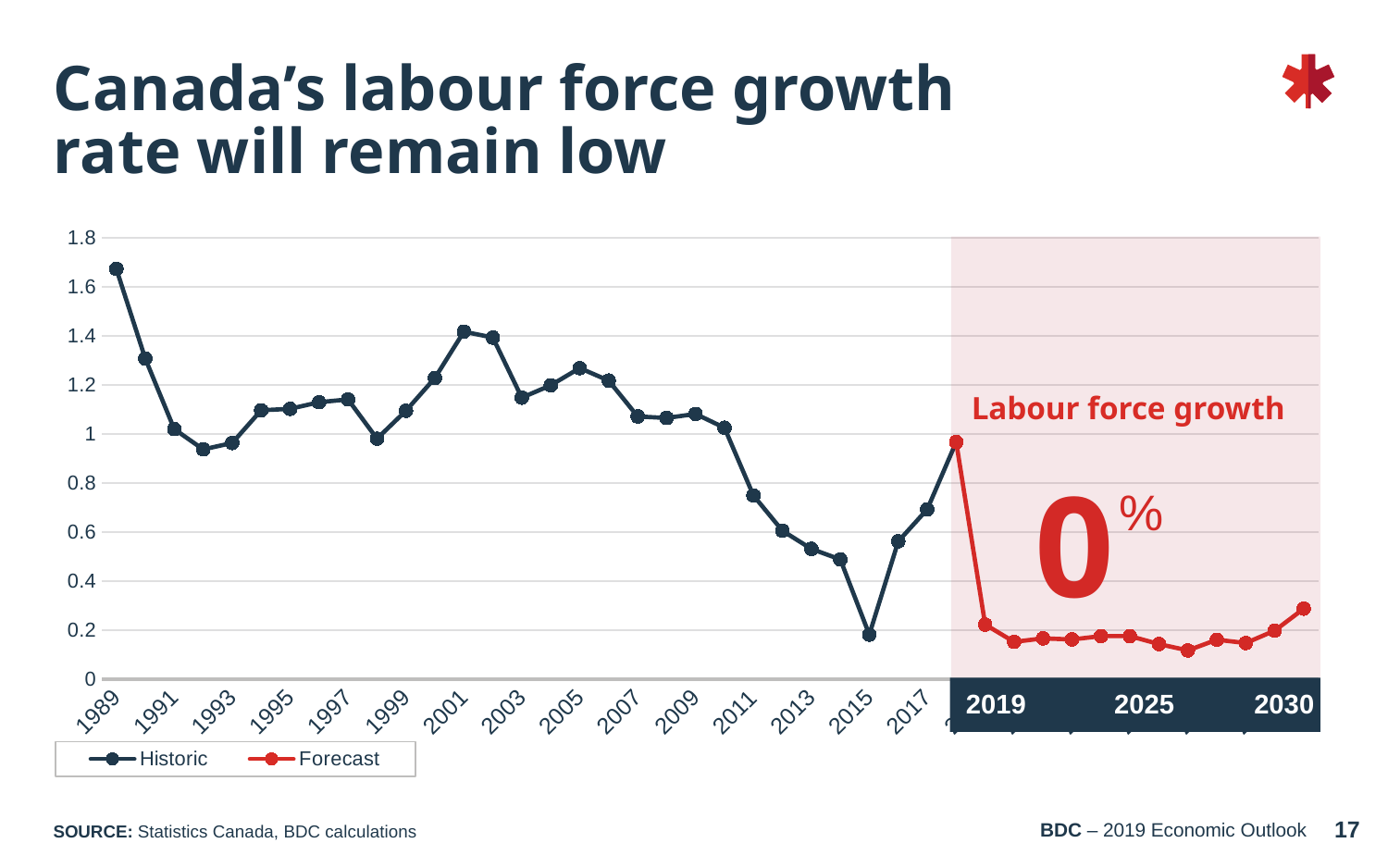
What are the two series named in the legend? Historic and Forecast Is the value for 1989 greater or less than 1.6? greater In which year is the labour force growth rate highest? 1989 What kind of chart is shown on the slide? Line chart Is the value for 2017 greater or less than 0.8? less How many series does the legend list? 2 Does the Historic line overall rise or fall from 1989 to 2017? Fall Is the value for 2015 greater or less than 0.4? less Which is larger, the value for 1989 or the value for 2015? 1989 What colour is the Forecast line? Red